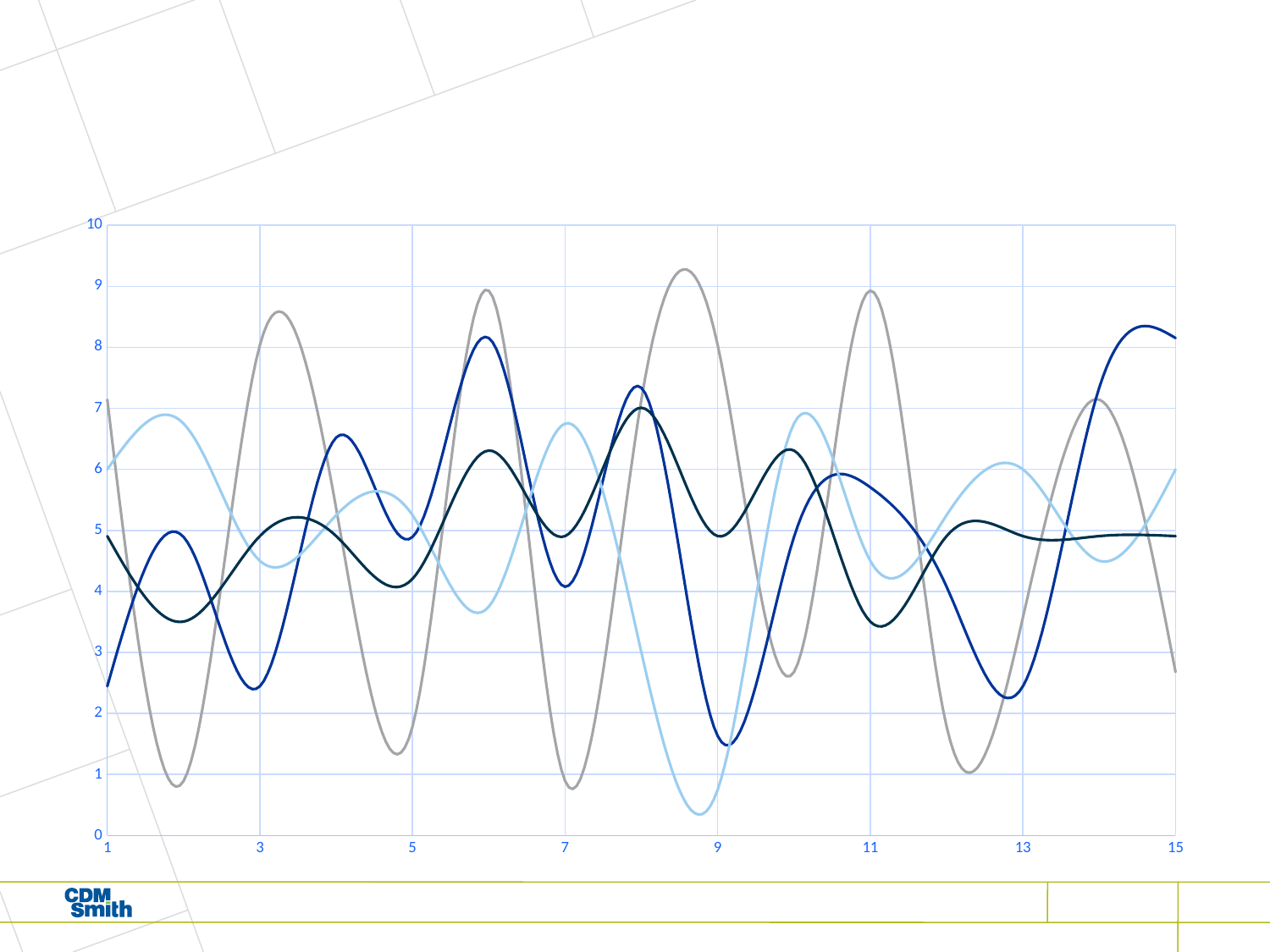
What is the highest value labeled on the y axis? 10 At x = 9, which line is higher, the gray line or the medium blue line? the gray line What kind of chart is shown on the slide? line chart Is the value of the light blue line at x = 9 greater or less than 2? less Is the value of the dark navy line at x = 15 greater or less than 6? less How many lines are plotted on the chart? 4 Is the value of the gray line at x = 3 greater or less than 7? greater At x = 3, which line is higher, the gray line or the light blue line? the gray line What is the last value labeled on the x axis? 15